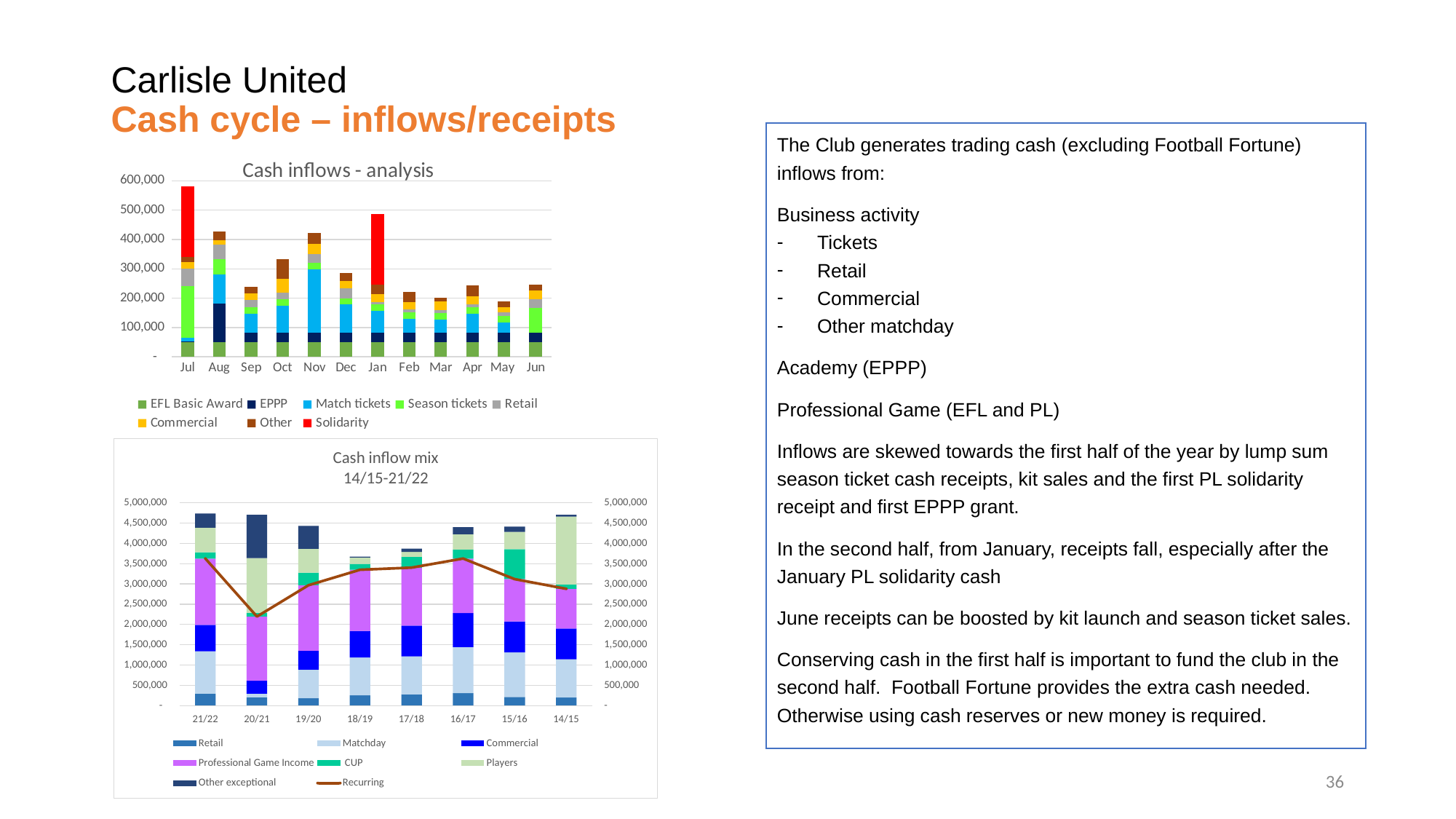
In the 'Cash inflows - analysis' chart, is the total for Nov greater or less than 300,000? greater In the 'Cash inflow mix 14/15-21/22' chart, in which season is the Recurring line at its lowest? 20/21 In the 'Cash inflows - analysis' chart, is the total for Sep greater or less than 300,000? less How many series does the legend of the 'Cash inflows - analysis' chart list? 8 In the 'Cash inflows - analysis' chart, is the total for Jul greater or less than 500,000? greater In the 'Cash inflows - analysis' chart, which month has the highest total cash inflow? Jul What kind of chart is 'Cash inflows - analysis'? Stacked bar chart In the 'Cash inflow mix 14/15-21/22' chart, which season has the lowest total bar? 18/19 In the 'Cash inflows - analysis' chart, what colour represents Solidarity in the legend? Red In the 'Cash inflows - analysis' chart, which is larger, the total for Jan or the total for Aug? Jan How many months are shown on the x axis of the 'Cash inflows - analysis' chart? 12